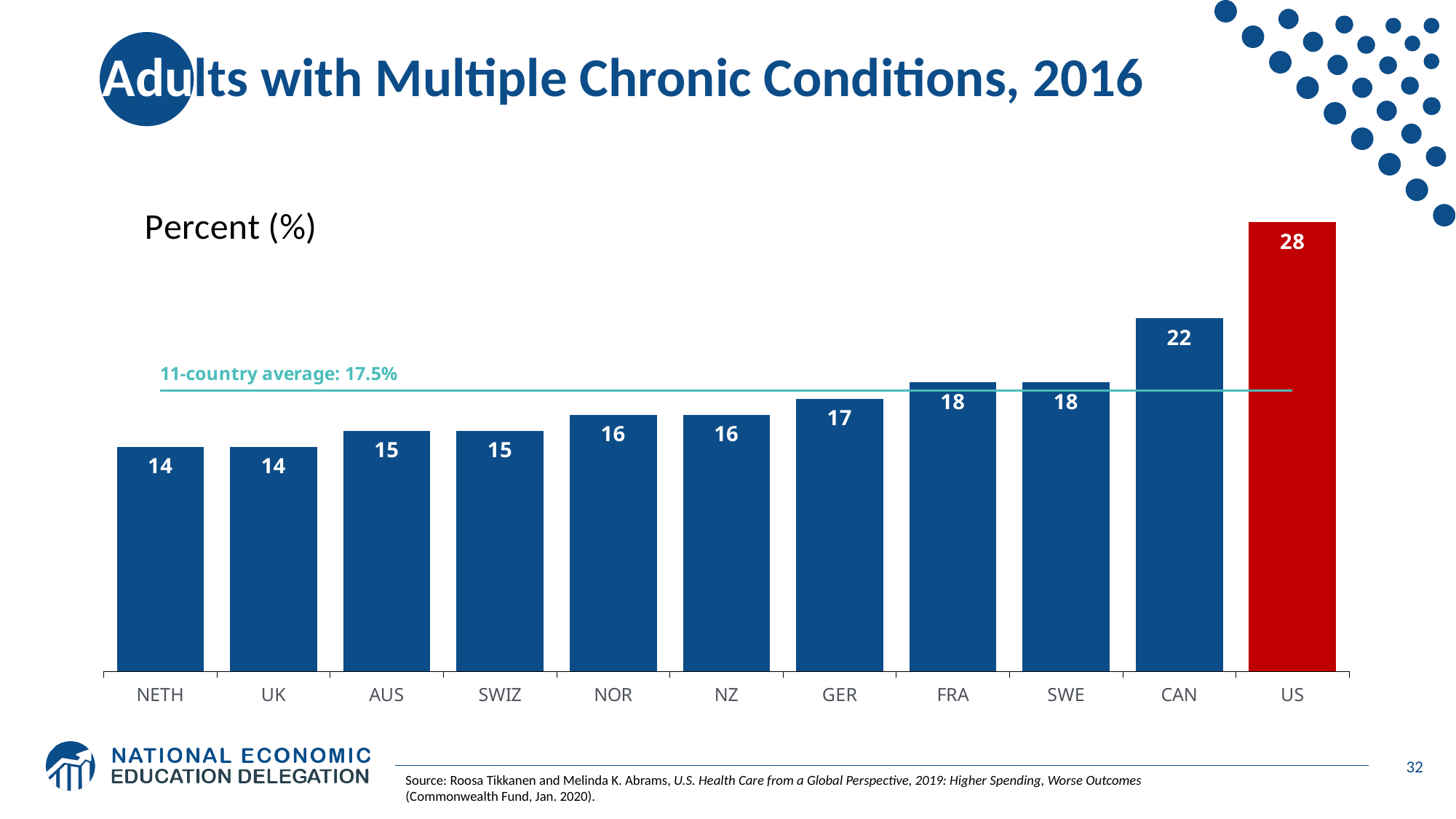
Which country has the highest value? US Which is larger, the value for NOR or the value for FRA? FRA What is the value for CAN? 22 What is the value for the US? 28 Do the values rise or fall from NETH to US along the x axis? Rise What is the difference between the values for SWE and NETH? 4 What kind of chart is shown on the slide? Bar chart What is the 11-country average shown on the chart? 17.5% Which bar is coloured red? US What is the value for GER? 17 What is the difference between the values for the US and CAN? 6 How many countries are shown on the chart? 11